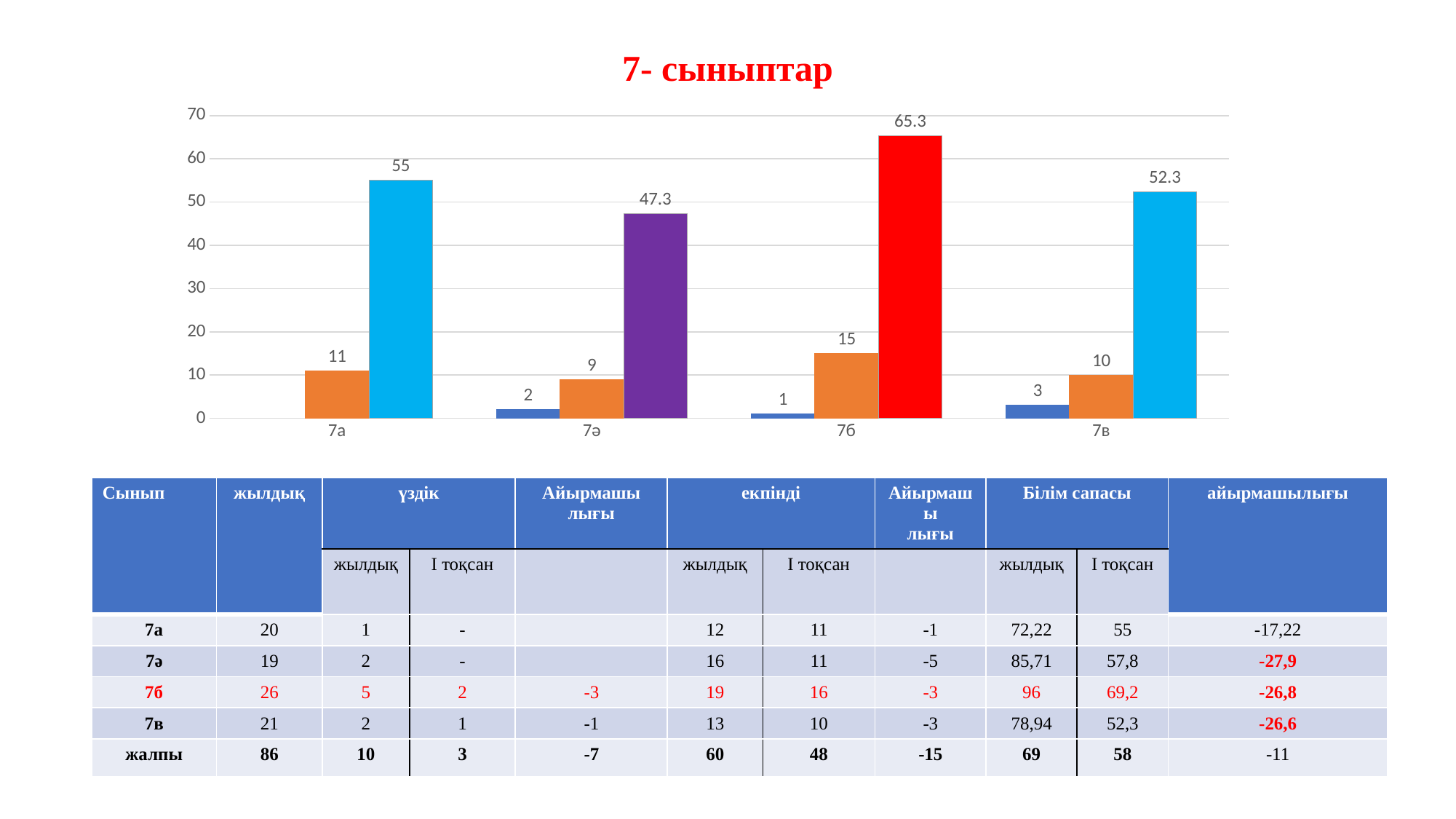
What is the title of the chart? 7- сыныптар What type of chart is shown on the slide? bar chart What is the value of the tallest bar for category 7б? 65.3 What is the value of the blue bar for category 7б? 1 What is the value of the orange bar for category 7в? 10 What is the value of the orange bar for category 7ә? 9 What is the value of the tallest bar for category 7а? 55 Which is larger: the orange bar for 7а or the orange bar for 7б? 7б Which category has the highest bar in the chart? 7б How many categories are shown on the x axis of the chart? 4 What is the difference between the tallest bar for 7б (65.3) and the tallest bar for 7в (52.3)? 13 Which category has the lowest value among the tallest bars of each category? 7ә